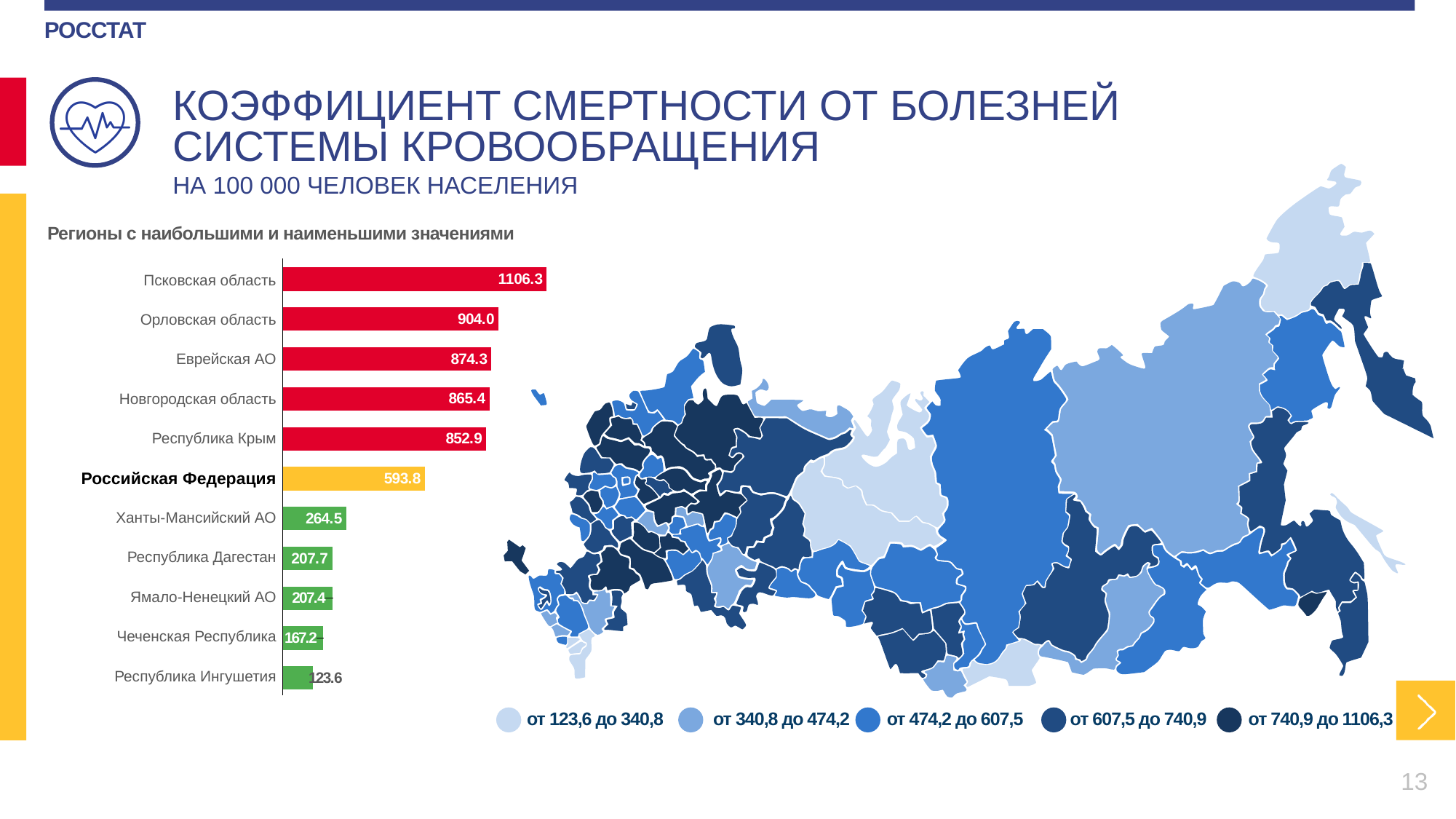
What is the value for Чеченская Республика in the bar chart? 167.2 How many categories (bars) are shown in the bar chart? 11 What is the difference between the values for Псковская область and Орловская область? 202.3 What kind of chart is used to show the regions with the highest and lowest values? Bar chart What is the value for Республика Крым in the bar chart? 852.9 What is the difference between the values for Российская Федерация and Ханты-Мансийский АО? 329.3 Which is larger: the value for Еврейская АО or the value for Новгородская область? Еврейская АО Which region has the lowest value in the bar chart? Республика Ингушетия What is the value shown for Российская Федерация in the bar chart? 593.8 What is the value for Псковская область in the bar chart? 1106.3 How many value ranges are listed in the map legend? 5 Which region has the highest value in the bar chart? Псковская область